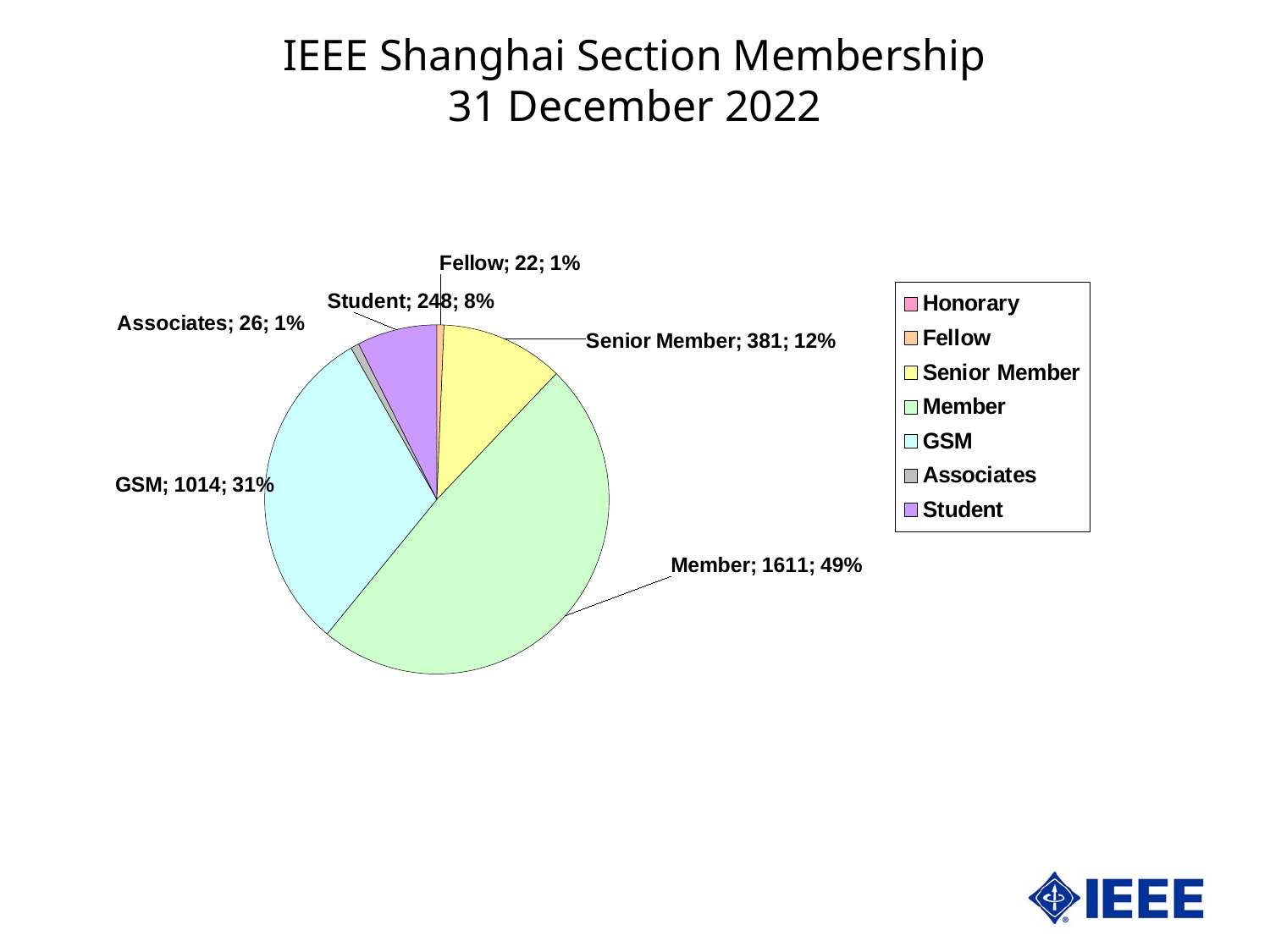
How many members are in the Member category? 1611 What is the value shown for GSM? 1014 Which is larger, Senior Member or Student? Senior Member What is the value shown for Fellow? 22 What is the value shown for Student? 248 What is the value shown for Senior Member? 381 How many entries does the legend list? 7 What kind of chart is shown on the slide? pie chart What is the difference between the Member value and the GSM value? 597 Which category has the largest slice of the pie? Member What share of the pie does Member represent? 49% What share of the pie does GSM represent? 31%